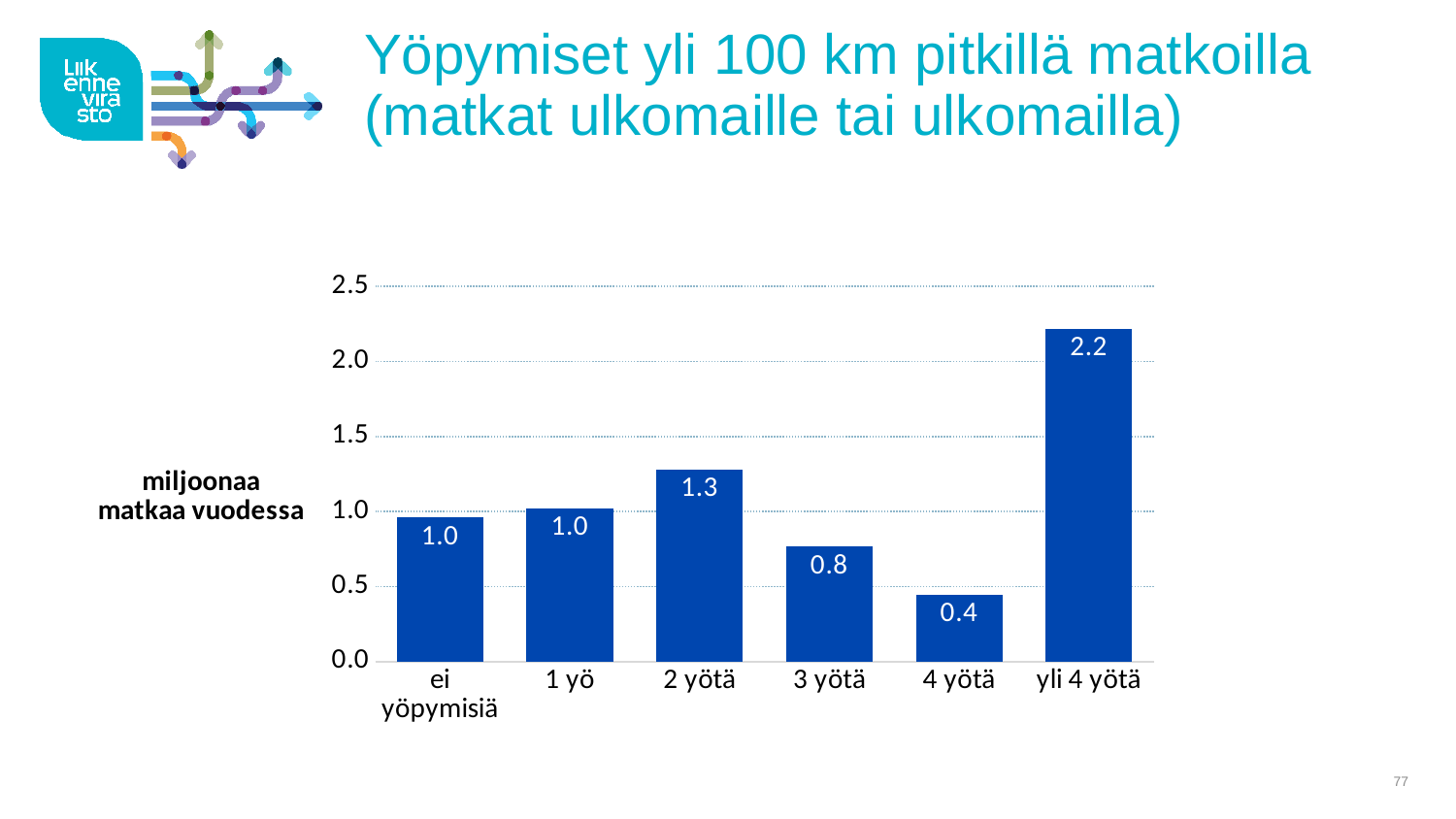
What is the value for '3 yötä'? 0.8 What unit is given for the y axis of the chart? miljoonaa matkaa vuodessa What is the difference between the values for 'yli 4 yötä' and '2 yötä'? 0.9 Which category has the highest value? yli 4 yötä What is the value for '4 yötä'? 0.4 Is the value for 'yli 4 yötä' greater or less than 2.0? greater What is the value for '2 yötä'? 1.3 What is the value for 'yli 4 yötä'? 2.2 Which is larger, the value for '3 yötä' or the value for '4 yötä'? 3 yötä How many categories are shown on the x axis? 6 What kind of chart is shown on the slide? bar chart Which category has the lowest value? 4 yötä